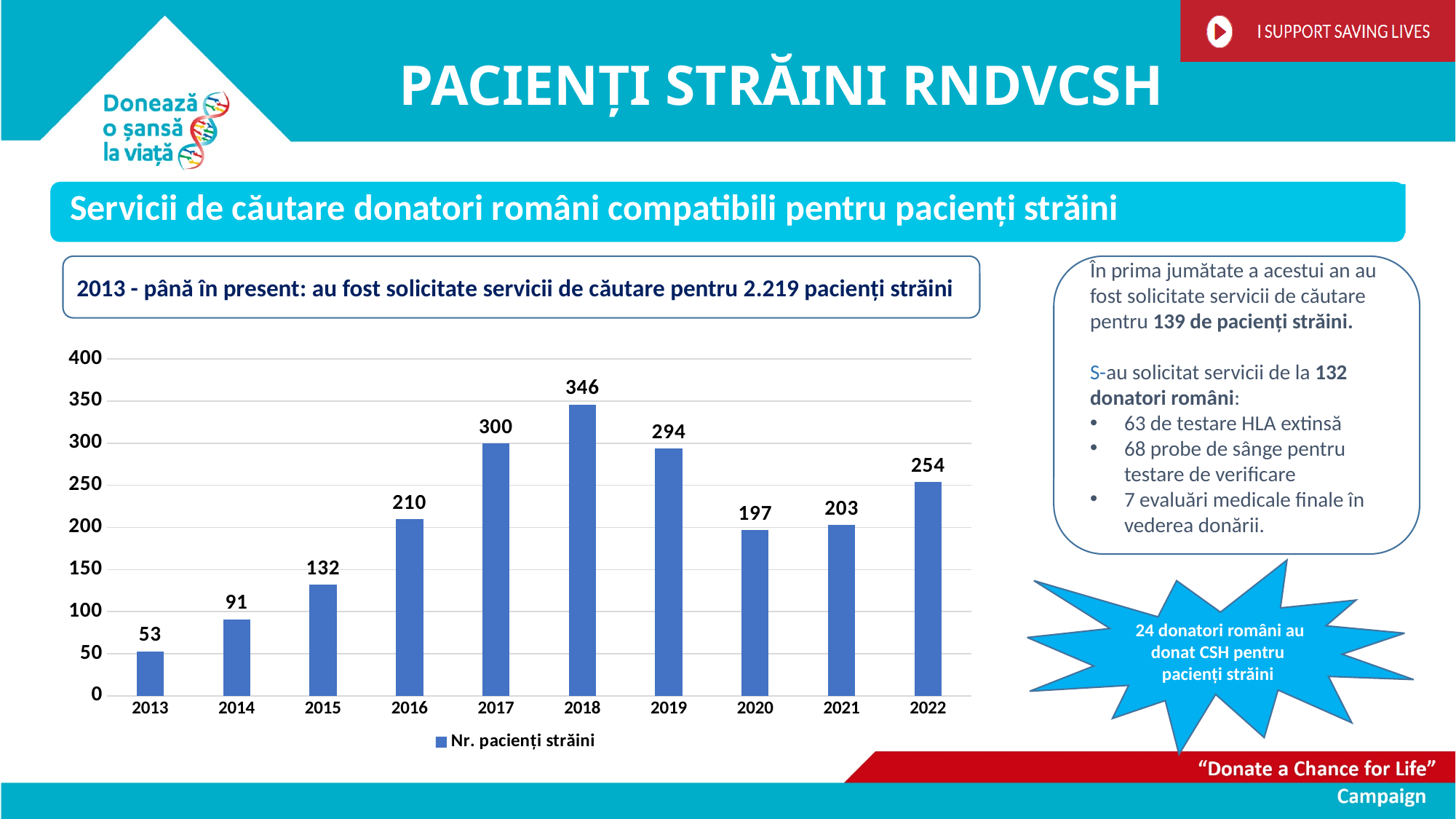
Which year has the highest value? 2018 What is the difference between the values for 2018 and 2019? 52 How many series does the legend list? 1 Which is larger, the value for 2017 or the value for 2022? 2017 Which year has the lowest value? 2013 What is the value for 2013? 53 What is the legend entry for the series? Nr. pacienți străini How many years are shown on the x axis? 10 What is the value for 2020? 197 What kind of chart is shown? bar chart Is the value for 2021 greater or less than 250? less What is the value for 2018? 346